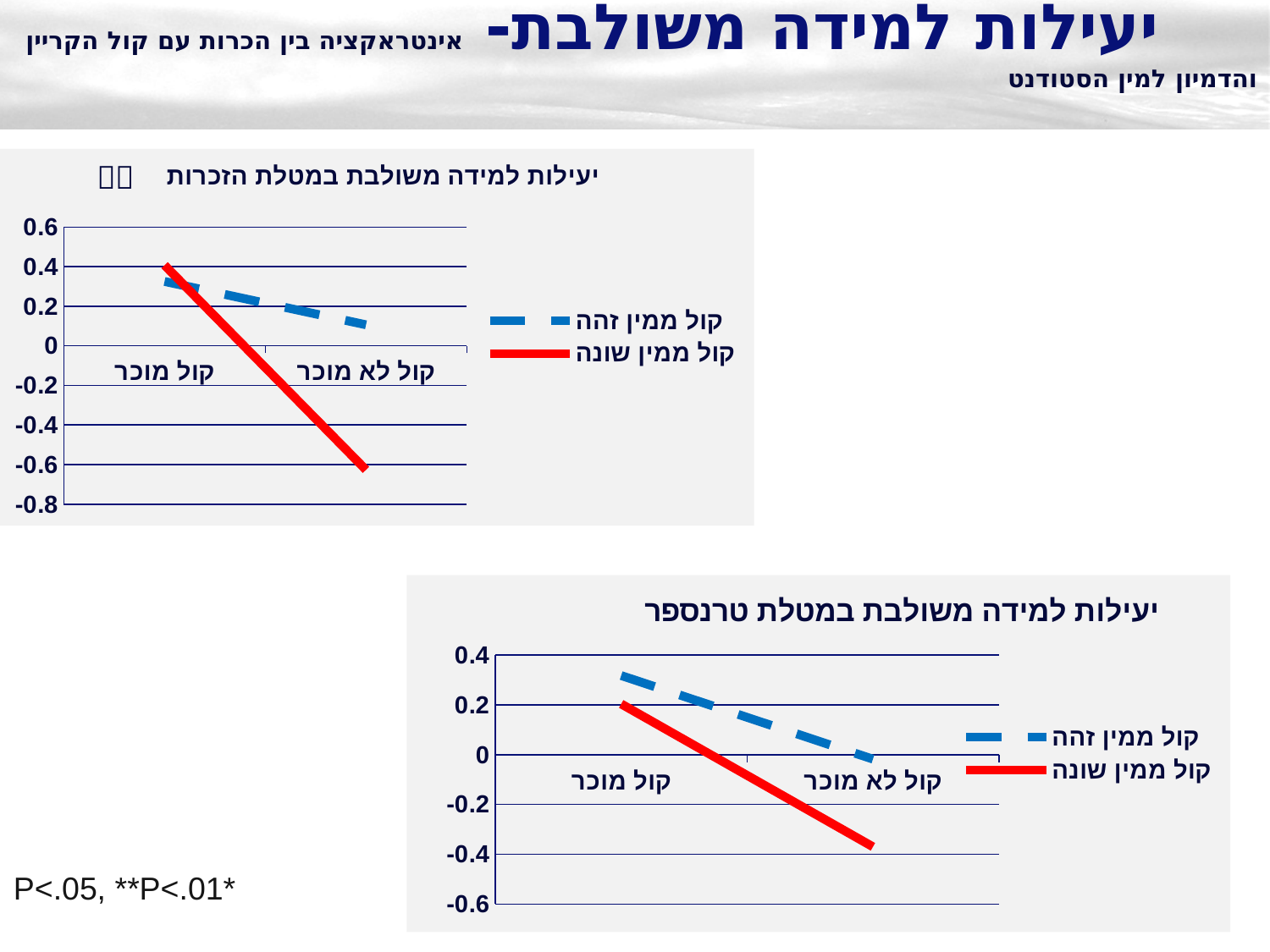
How many categories are shown on the x axis of the bottom chart ("יעילות למידה משולבת במטלת טרנספר")? 2 In the top chart ("יעילות למידה משולבת במטלת הזכרות"), is the value of "קול ממין זהה" at "קול לא מוכר" greater or less than 0? greater What type of chart is the top chart titled "יעילות למידה משולבת במטלת הזכרות"? line chart In the top chart ("יעילות למידה משולבת במטלת הזכרות"), is the value of "קול ממין שונה" at "קול לא מוכר" greater or less than -0.4? less In the bottom chart ("יעילות למידה משולבת במטלת טרנספר"), is the value of "קול ממין שונה" at "קול לא מוכר" greater or less than -0.2? less In the top chart ("יעילות למידה משולבת במטלת הזכרות"), does the "קול ממין שונה" series rise or fall from "קול מוכר" to "קול לא מוכר"? fall In the bottom chart ("יעילות למידה משולבת במטלת טרנספר"), which series is drawn as a solid red line? קול ממין שונה In the bottom chart ("יעילות למידה משולבת במטלת טרנספר"), which series has the higher value at "קול לא מוכר"? קול ממין זהה How many series does the legend of the top chart ("יעילות למידה משולבת במטלת הזכרות") list? 2 In the top chart ("יעילות למידה משולבת במטלת הזכרות"), which series has the higher value at "קול לא מוכר"? קול ממין זהה